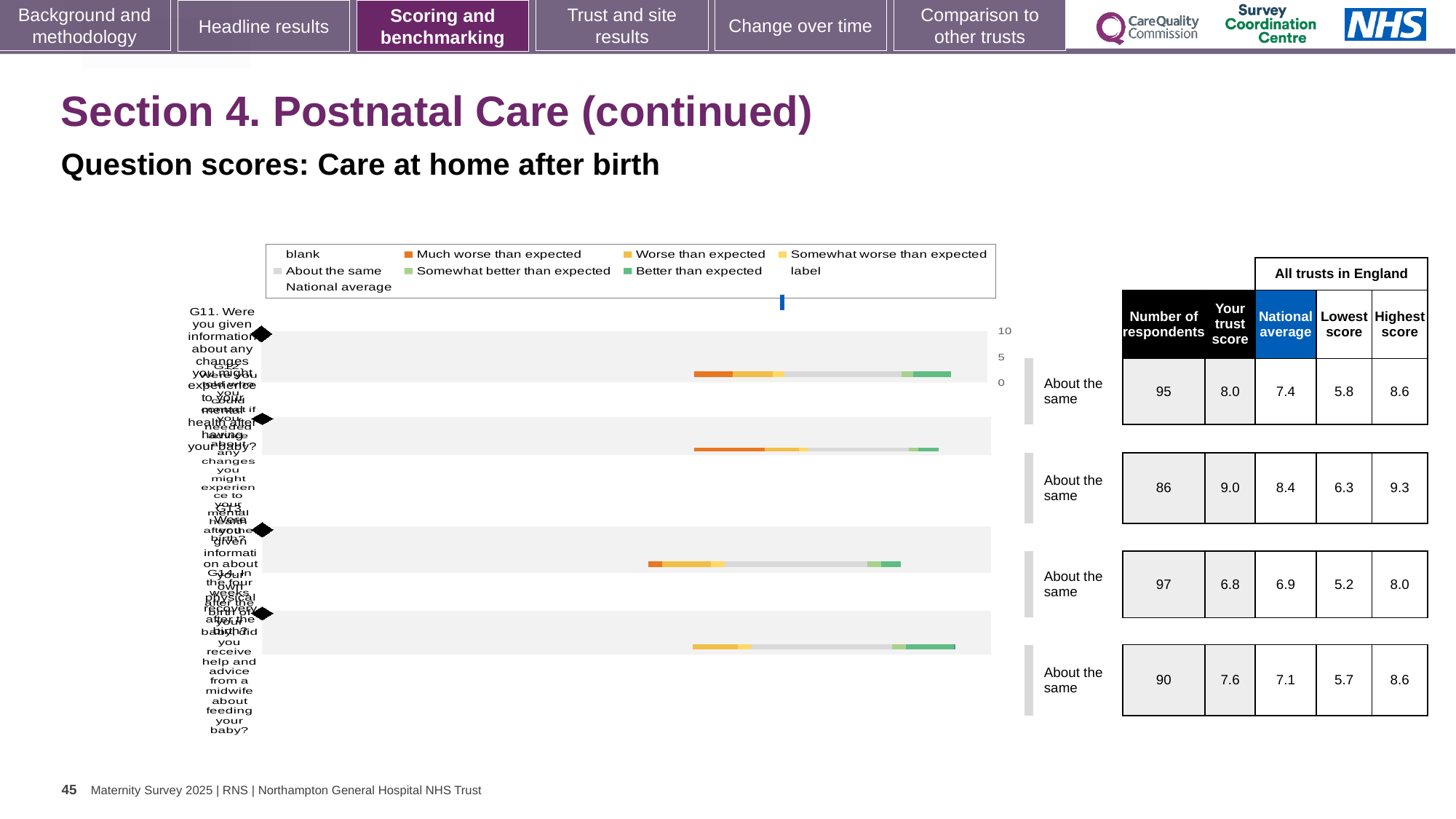
In the table next to the chart, what is the lowest 'Your trust score' value? 6.8 In the table next to the chart, what is the number of respondents in the first row? 95 In the table next to the chart, which is larger in the first row: the trust score or the national average? trust score In the table next to the chart, what is the difference between the trust score and the national average in the second row? 0.6 In the chart legend, what colour represents 'About the same'? grey What kind of chart is shown on the slide? bar chart How many bars are plotted in the chart? 4 In the table next to the chart, what is the national average in the second row? 8.4 In the table next to the chart, what is the highest 'Your trust score' value? 9.0 What benchmark label is shown for each of the four rows beside the chart? About the same In the chart legend, what colour represents 'Much worse than expected'? orange In the table next to the chart, what is the highest score in the third row? 8.0